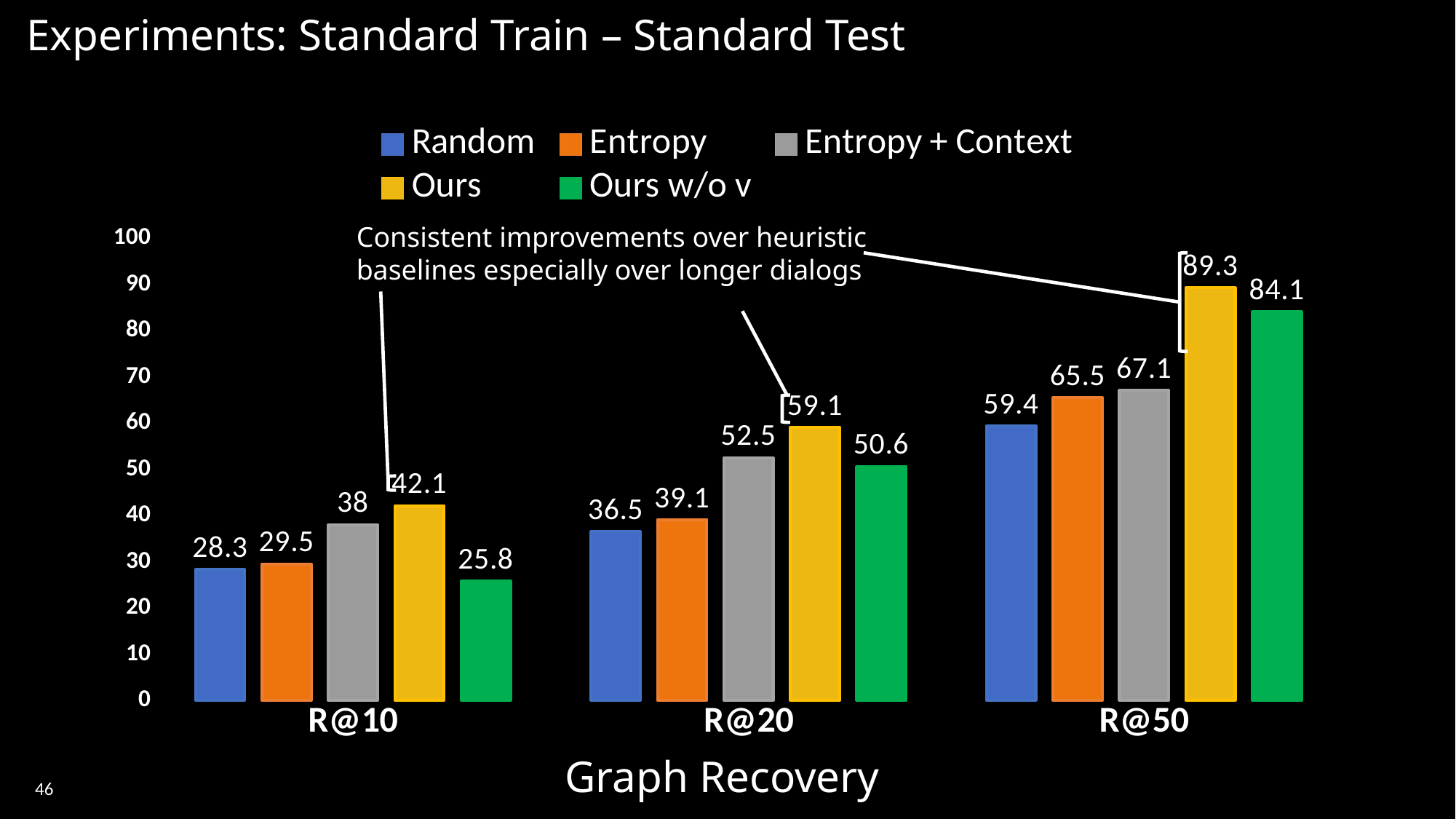
What is the value for Ours at R@50? 89.3 How many categories are shown on the x axis? 3 What is the value for Ours w/o v at R@10? 25.8 What is the difference between Ours and Entropy + Context at R@50? 22.2 Which is larger at R@20: Entropy or Random? Entropy What kind of chart is shown? Bar chart Does the value for Ours rise or fall from R@10 to R@50? Rise Which series has the lowest value at R@10? Ours w/o v What is the value for Entropy + Context at R@20? 52.5 What is the value for Random at R@10? 28.3 How many series does the legend list? 5 Which series has the highest value at R@20? Ours